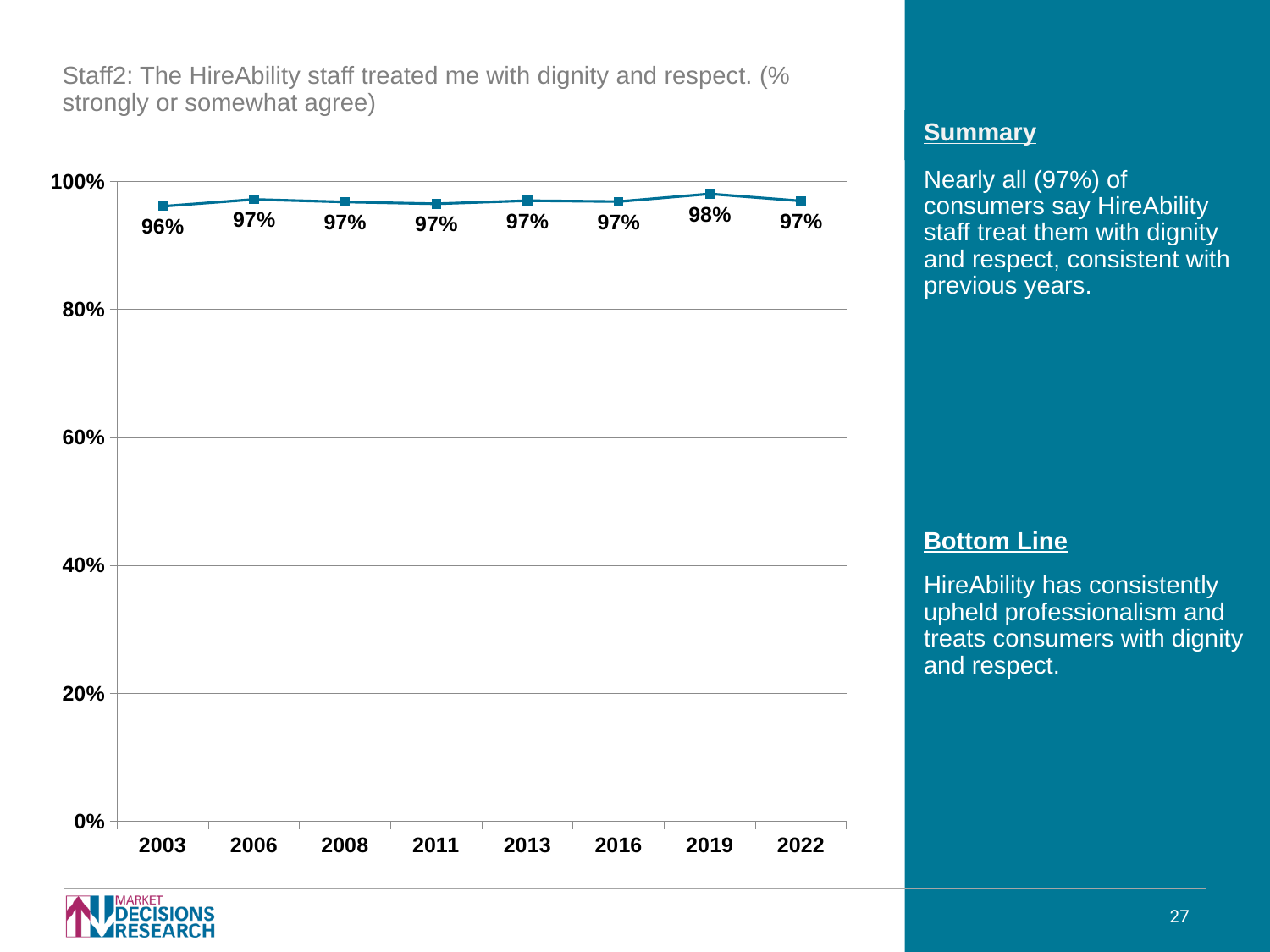
How many years are plotted on the chart? 8 Is the value for 2013 greater or less than 80%? greater What is the value for 2011? 97% What is the title of the chart? Staff2: The HireAbility staff treated me with dignity and respect. (% strongly or somewhat agree) Which year has the lowest value? 2003 What is the value for 2003? 96% What kind of chart is shown on the slide? line chart What is the value for 2022? 97% What is the difference between the values for 2019 and 2003? 2% Which is larger, the value for 2019 or the value for 2022? 2019 Which year has the highest value? 2019 What is the value for 2019? 98%